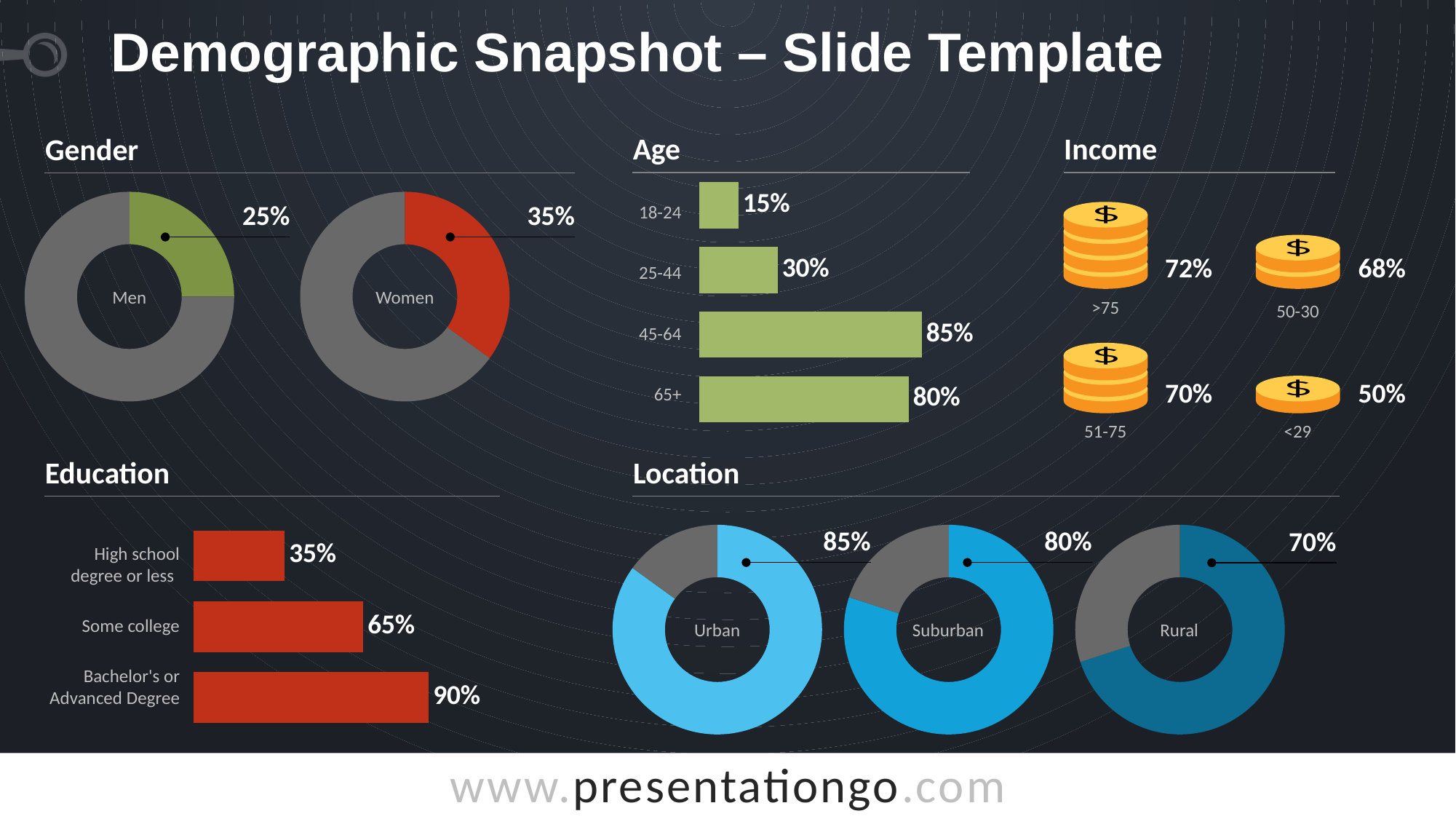
In the Gender section, what is the value shown for Women? 35% In the Education bar chart, what is the difference between Bachelor's or Advanced Degree and High school degree or less? 55% In the Age bar chart, which age group has the lowest value? 18-24 In the Age bar chart, how many age groups are shown? 4 In the Education bar chart, what is the value for Some college? 65% In the Education bar chart, which category has the highest value? Bachelor's or Advanced Degree In the Location section, what is the value shown for Suburban? 80% In the Age bar chart, what is the value for the 45-64 age group? 85% In the Location section, which of Urban or Rural has the larger value? Urban In the Income section, what is the value shown for the <29 group? 50% What kind of chart is used in the Education section? Bar chart In the Age bar chart, what is the difference between the values for 45-64 and 25-44? 55%